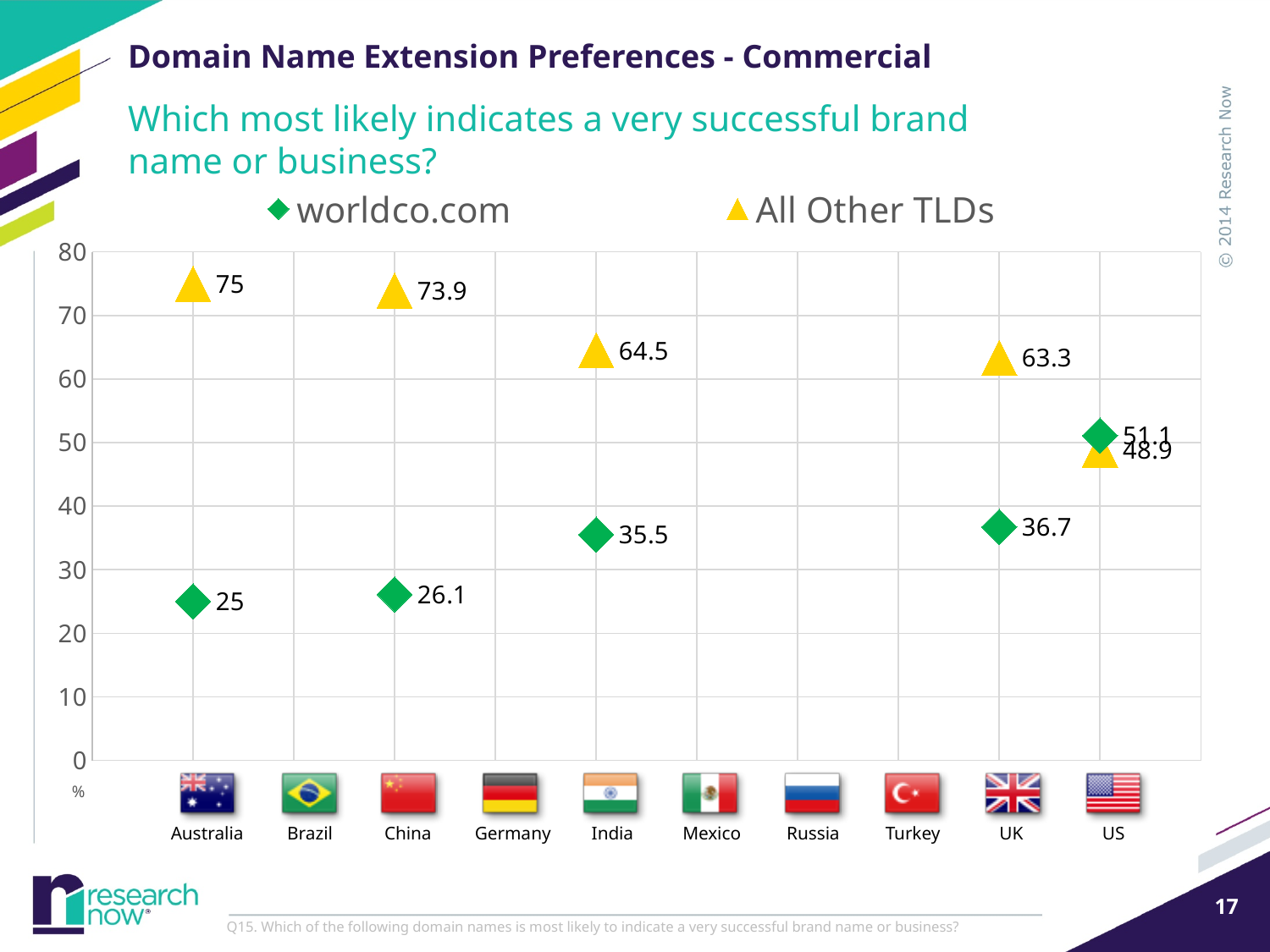
How many series does the legend list? 2 How many countries are listed along the x axis? 10 For the US, which is larger: the worldco.com value or the All Other TLDs value? worldco.com Which country has the highest All Other TLDs value? Australia What is the difference between the All Other TLDs value and the worldco.com value for the UK? 26.6 What is the worldco.com value for the US? 51.1 What is the All Other TLDs value for China? 73.9 What is the worldco.com value for India? 35.5 Is the worldco.com value for China greater or less than 30? less Which country has the lowest worldco.com value? Australia What is the total of the worldco.com and All Other TLDs values for Australia? 100 What marker shape is used for the worldco.com series? Diamond